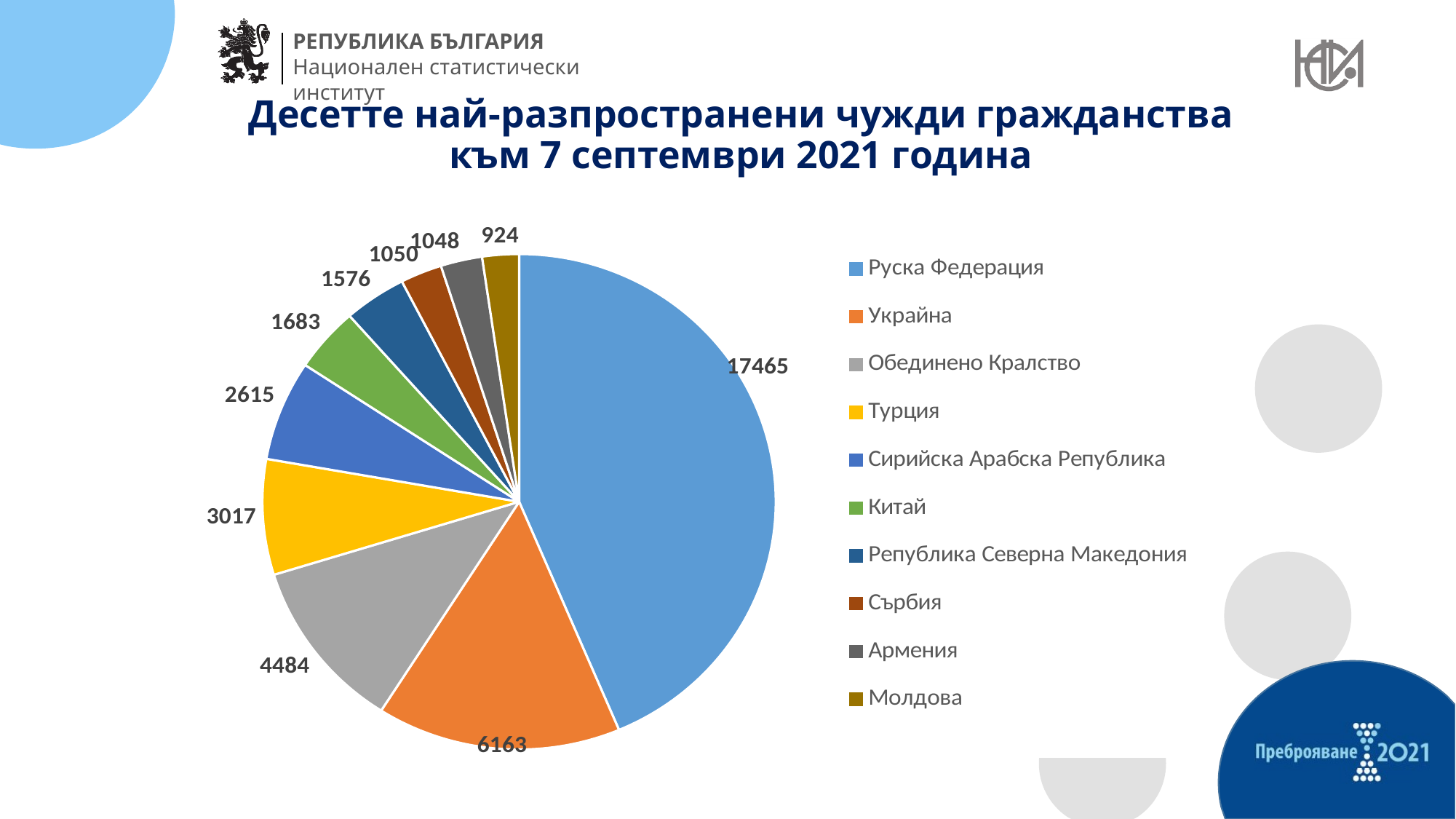
Which citizenship has the largest slice of the pie? Руска Федерация What is the value for Турция? 3017 How many entries does the legend list? 10 How many slices does the pie chart have? 10 Which is larger, the value for Турция or the value for Сирийска Арабска Република? Турция What is the value for Украйна? 6163 What is the value for Република Северна Македония? 1576 What colour is the slice for Китай? Green What is the difference between the values for Украйна and Обединено Кралство? 1679 What is the value for Руска Федерация? 17465 What type of chart is shown on the slide? Pie chart Which citizenship has the smallest slice of the pie? Молдова